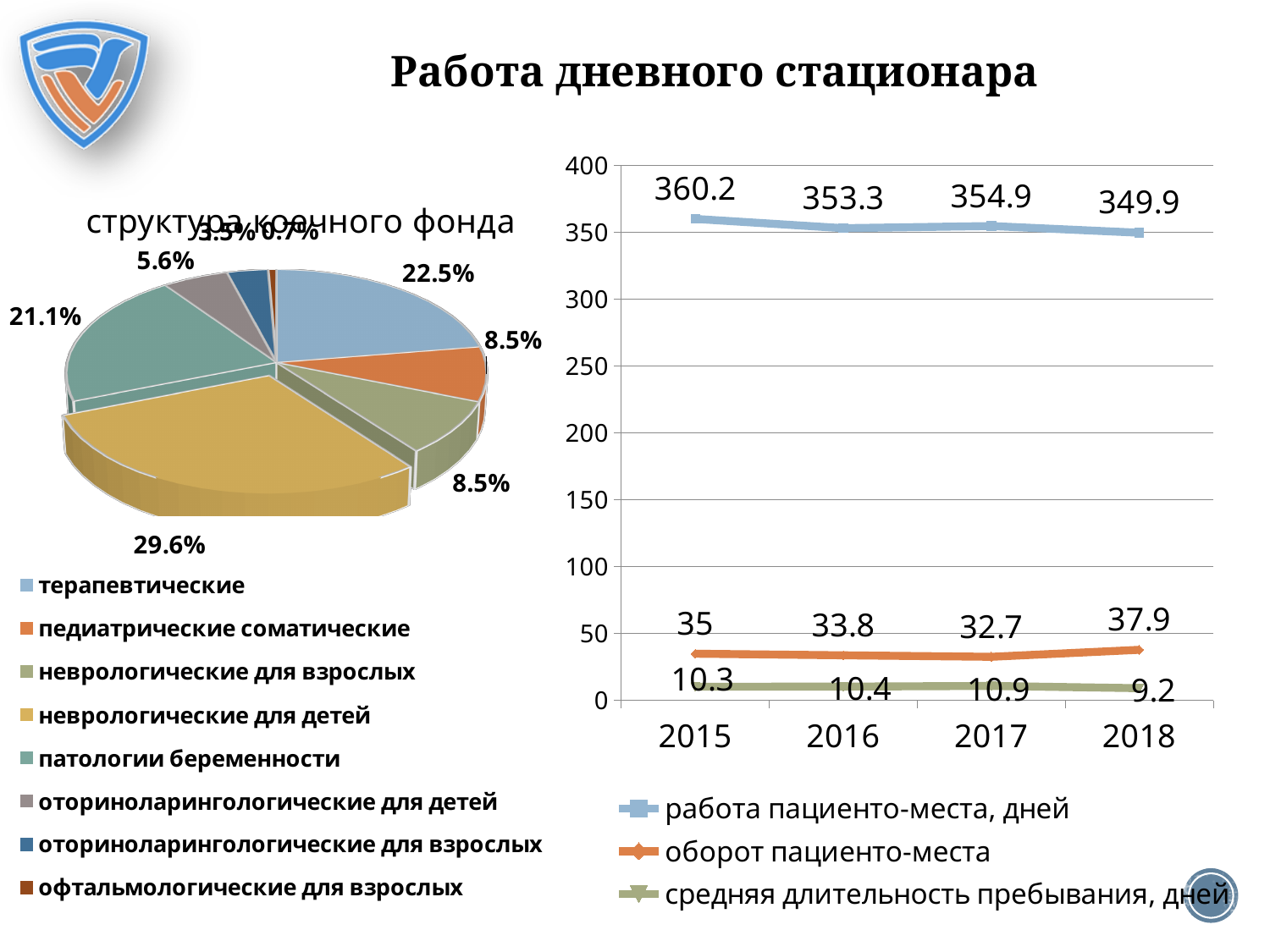
In the line chart, in which year is 'средняя длительность пребывания, дней' lowest? 2018 What kind of chart is the chart on the right side of the slide? line chart In the pie chart 'структура коечного фонда', which share is larger: 'терапевтические' or 'патологии беременности'? терапевтические In the line chart, what is the value of 'средняя длительность пребывания, дней' in 2017? 10.9 In the line chart, what is the value of 'работа пациенто-места, дней' in 2015? 360.2 In the pie chart 'структура коечного фонда', what share do 'неврологические для детей' beds have? 29.6% In the line chart, by how much did 'работа пациенто-места, дней' decrease from 2015 to 2018? 10.3 In the line chart, what is the value of 'оборот пациенто-места' in 2018? 37.9 How many years are shown on the x axis of the line chart? 4 In the line chart, in which year is 'работа пациенто-места, дней' highest? 2015 In the pie chart 'структура коечного фонда', which category has the largest share? неврологические для детей How many series does the legend of the line chart list? 3